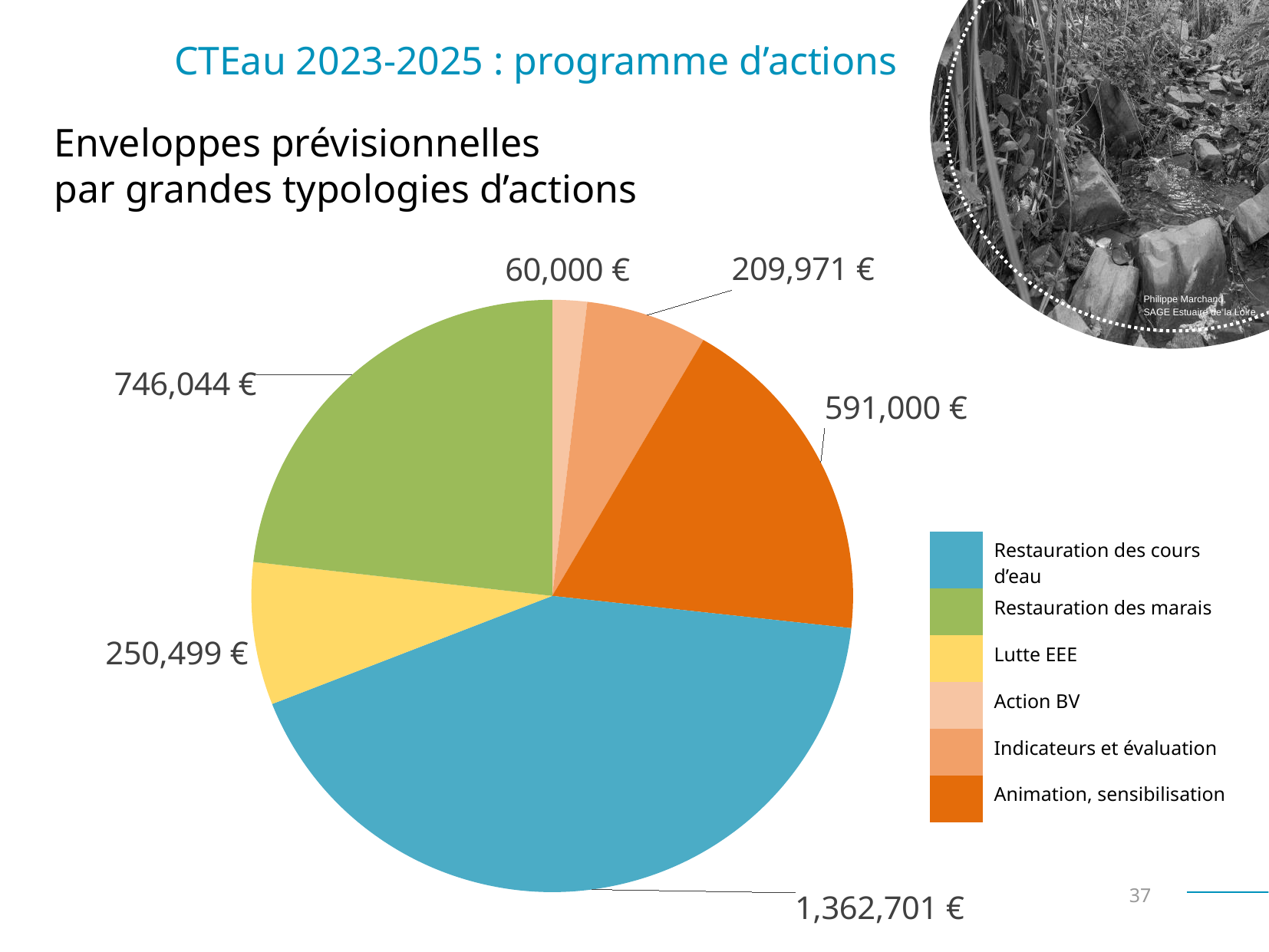
What colour is the slice for Lutte EEE? Yellow Which category has the largest slice of the pie? Restauration des cours d'eau What is the difference between Animation, sensibilisation and Lutte EEE? 340,501 € What is the value for Restauration des cours d'eau? 1,362,701 € What is the difference between Restauration des cours d'eau and Restauration des marais? 616,657 € What is the value for Restauration des marais? 746,044 € What is the value for Action BV? 60,000 € What is the value for Animation, sensibilisation? 591,000 € How many categories does the pie chart have? 6 Which is larger, Indicateurs et évaluation or Lutte EEE? Lutte EEE Which category has the smallest slice of the pie? Action BV What type of chart is shown on the slide? Pie chart